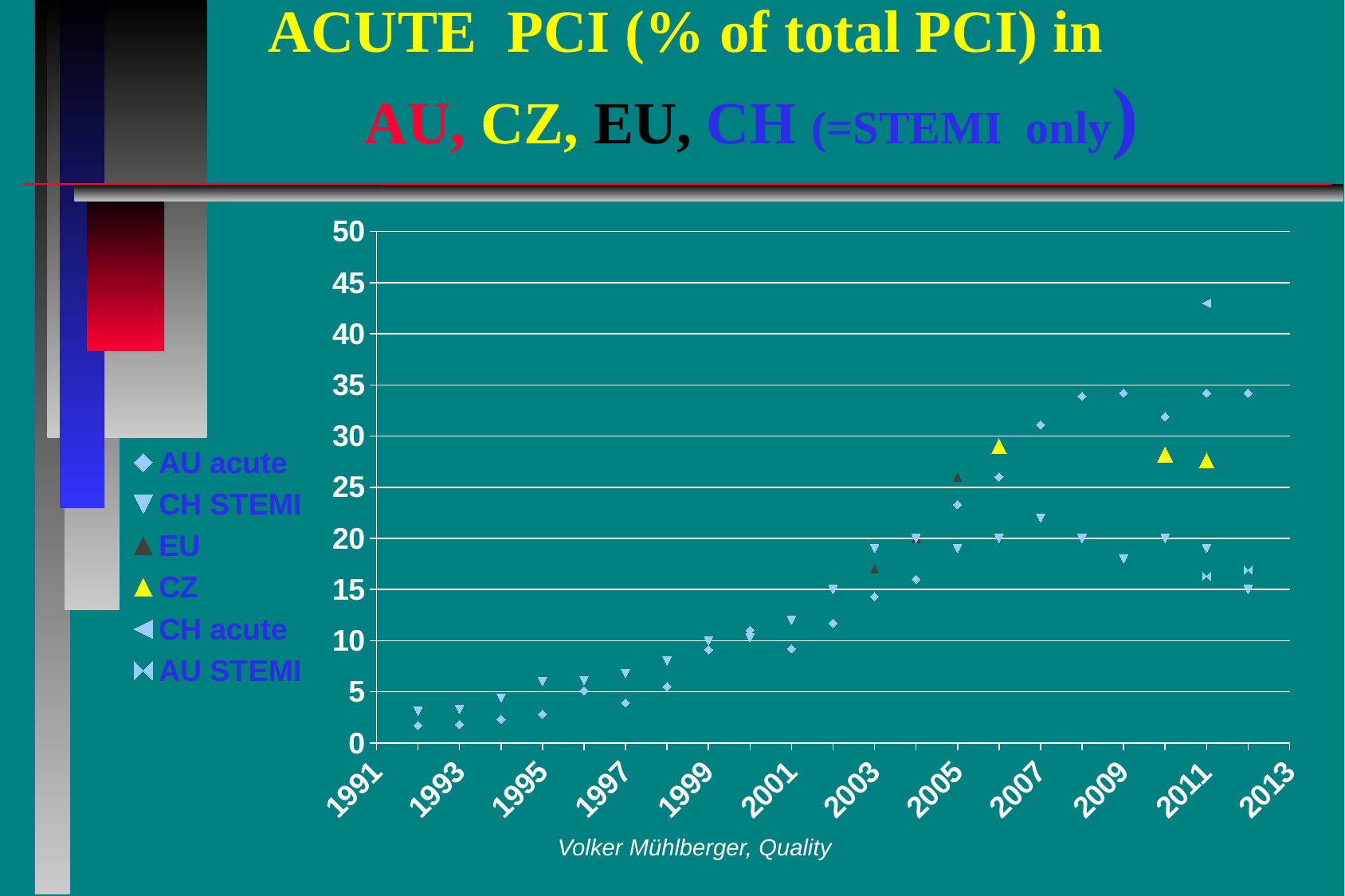
How many EU data points are plotted? 3 Is the value for CH acute in 2011 greater or less than 40? greater Is the value for CH STEMI in 2009 greater or less than 20? less Do the AU acute values generally rise or fall from 1992 to 2012? rise Is the value for AU acute in 1992 greater or less than 5? less How many CZ data points are plotted? 3 Which series is shown with yellow triangle markers? CZ How many series does the legend list? 6 What kind of chart is shown on the slide? scatter chart